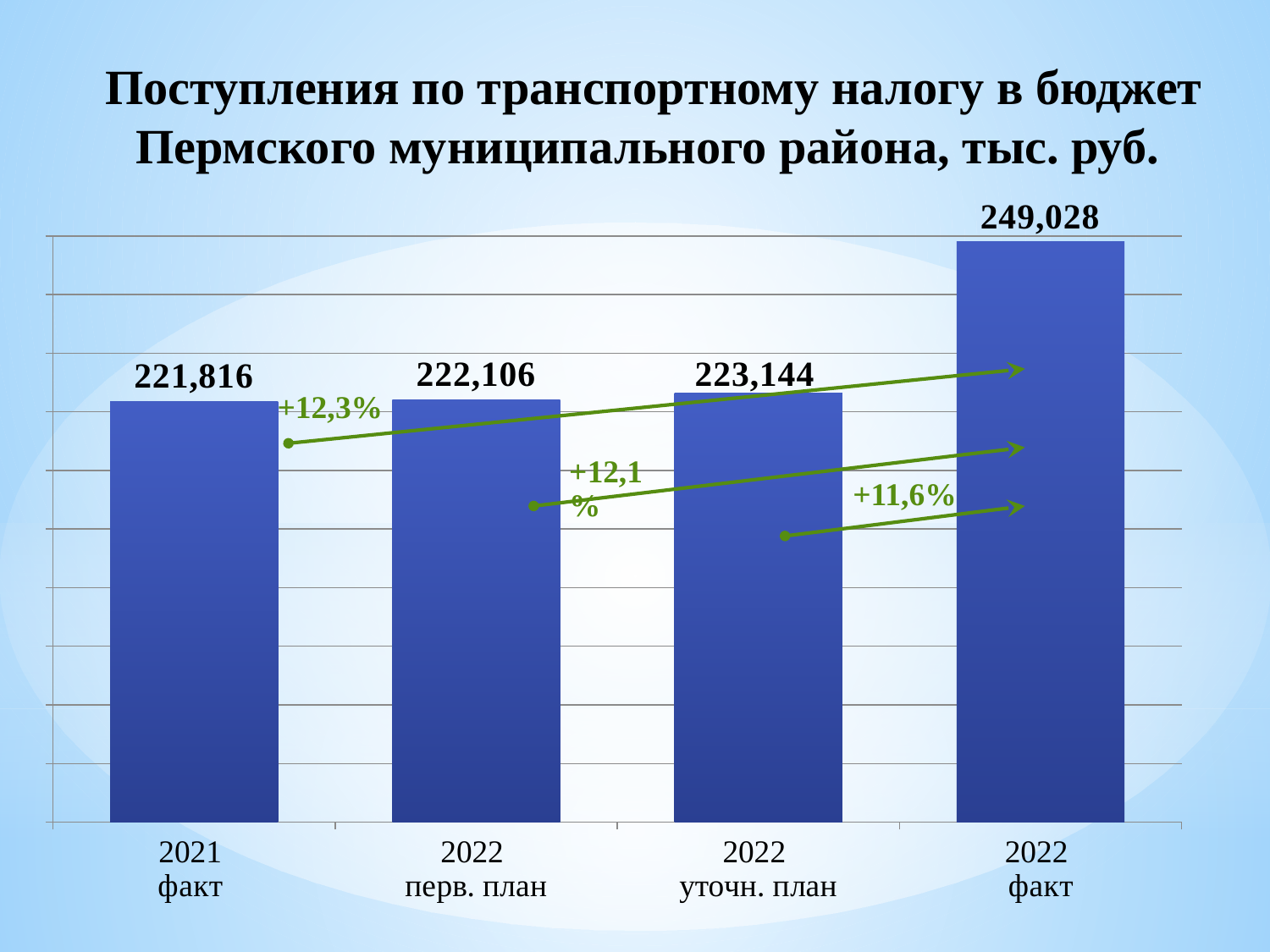
What is the value for 2021 факт? 221,816 What is the value for 2022 уточн. план? 223,144 What is the difference between the values for 2022 факт and 2022 уточн. план? 25,884 What percentage change is annotated on the arrow from 2021 факт to 2022 факт? +12,3% What is the value for 2022 факт? 249,028 What kind of chart is shown on the slide? bar chart Which category has the highest value? 2022 факт How many bars are shown in the chart? 4 Which category has the lowest value? 2021 факт Which is larger, the value for 2022 факт or the value for 2021 факт? 2022 факт What is the difference between the values for 2022 факт and 2021 факт? 27,212 What is the value for 2022 перв. план? 222,106